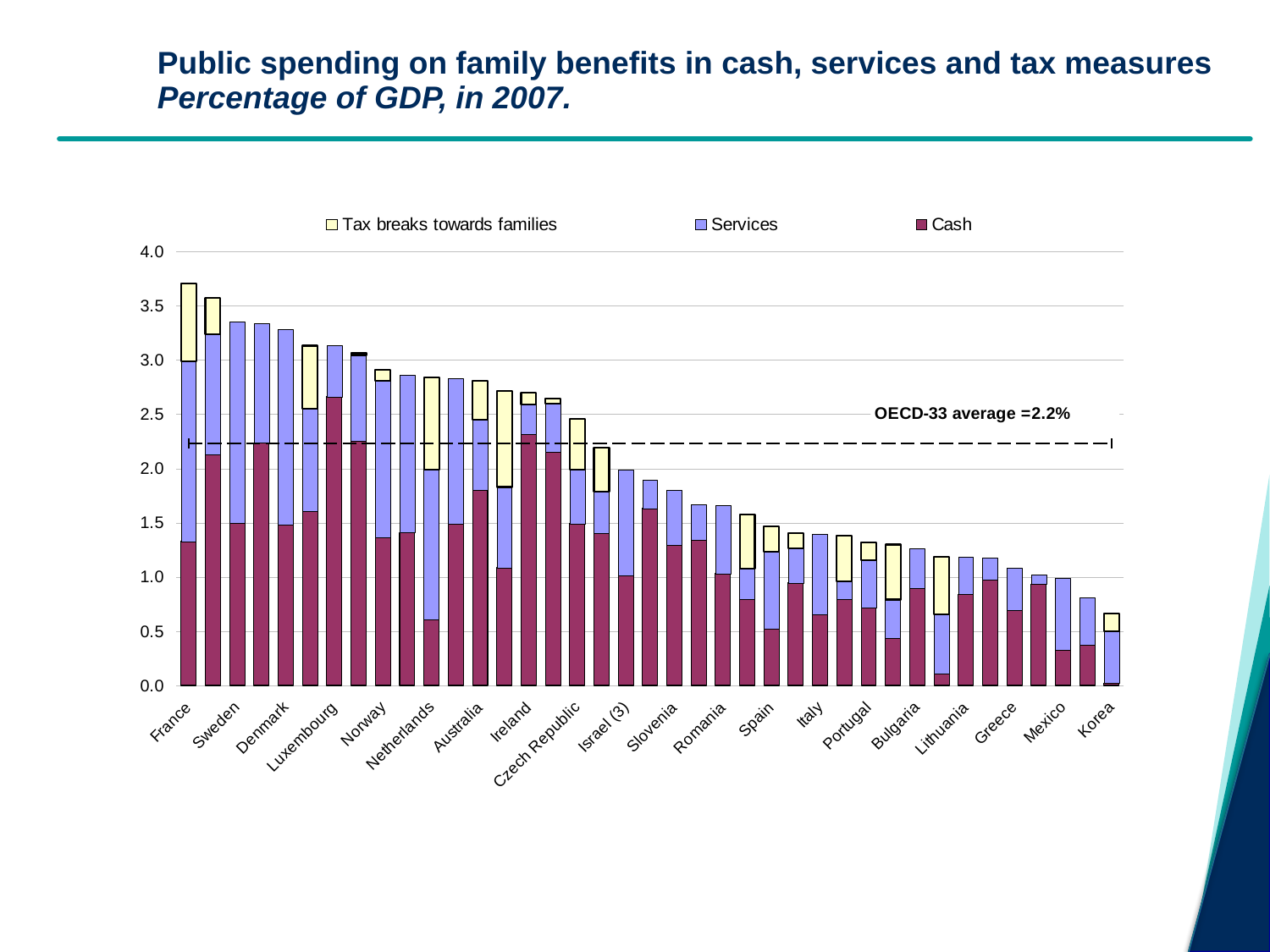
Is the total value for Korea greater or less than 1.0? less Which has a larger total, Denmark or Greece? Denmark Is the total value for Denmark greater or less than 3.0? greater Is the total value for Italy greater or less than 1.5? less How many series does the legend list? 3 What is the OECD-33 average shown on the chart? 2.2% Which labelled country has the lowest total public spending on family benefits? Korea What kind of chart is shown on the slide? Stacked bar chart Do the total values rise or fall moving from left to right along the x axis? Fall Which country has the highest total public spending on family benefits? France